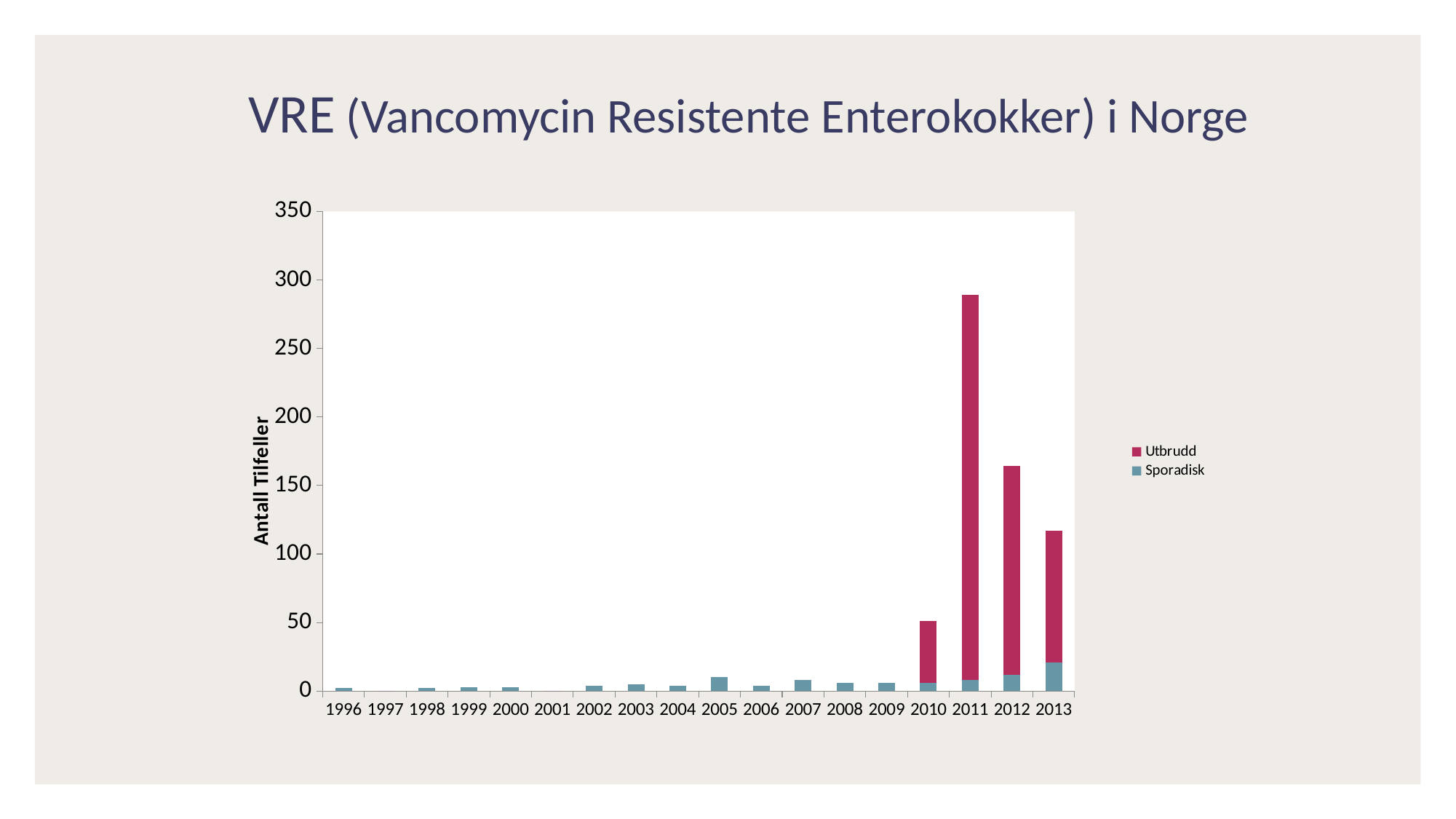
Is the total value for 2012 greater or less than 150? greater Is the total value for 2011 greater or less than 250? greater Which year has the larger total, 2012 or 2013? 2012 What is the label on the y axis? Antall Tilfeller How many series does the legend list? 2 Is the value for 2005 greater or less than 50? less What kind of chart is shown on the slide? Stacked bar chart Do the total values rise or fall from 2011 to 2013? fall Which year has the highest total number of cases? 2011 How many years are shown on the x axis? 18